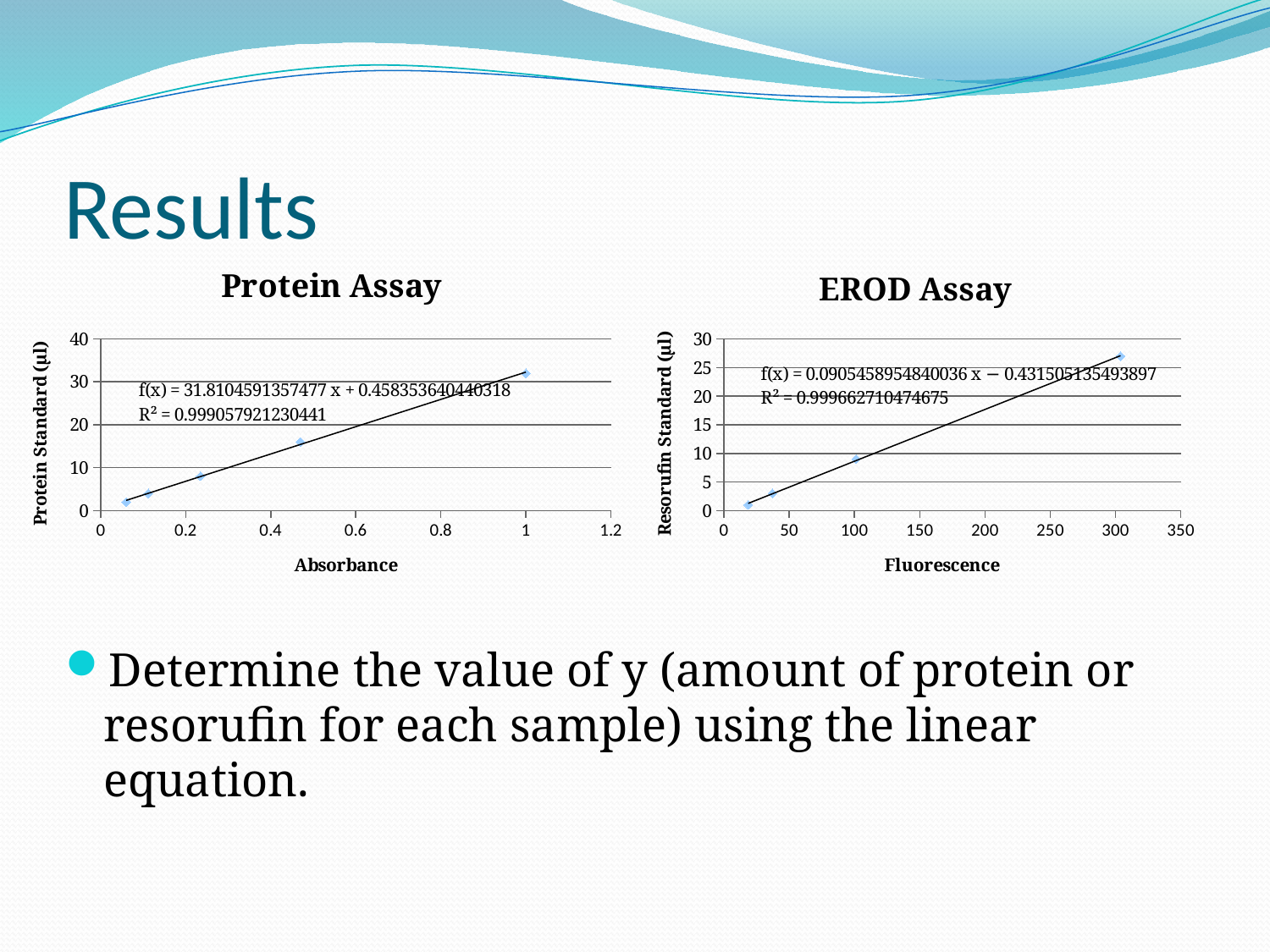
What is the R² value shown on the Protein Assay chart? 0.999057921230441 In the Protein Assay chart, is the Protein Standard value at an Absorbance of about 0.47 greater or less than 20? less In the EROD Assay chart, is the Resorufin Standard value at the highest Fluorescence point greater or less than 25? greater In the EROD Assay chart, do the plotted values rise or fall as Fluorescence increases? rise What kind of chart is the Protein Assay chart? scatter chart What is the x-axis label of the EROD Assay chart? Fluorescence What is the R² value shown on the EROD Assay chart? 0.999662710474675 How many data points are plotted in the Protein Assay chart? 5 In the Protein Assay chart, is the Protein Standard value at the highest Absorbance point greater or less than 30? greater In the Protein Assay chart, do the plotted values rise or fall as Absorbance increases? rise